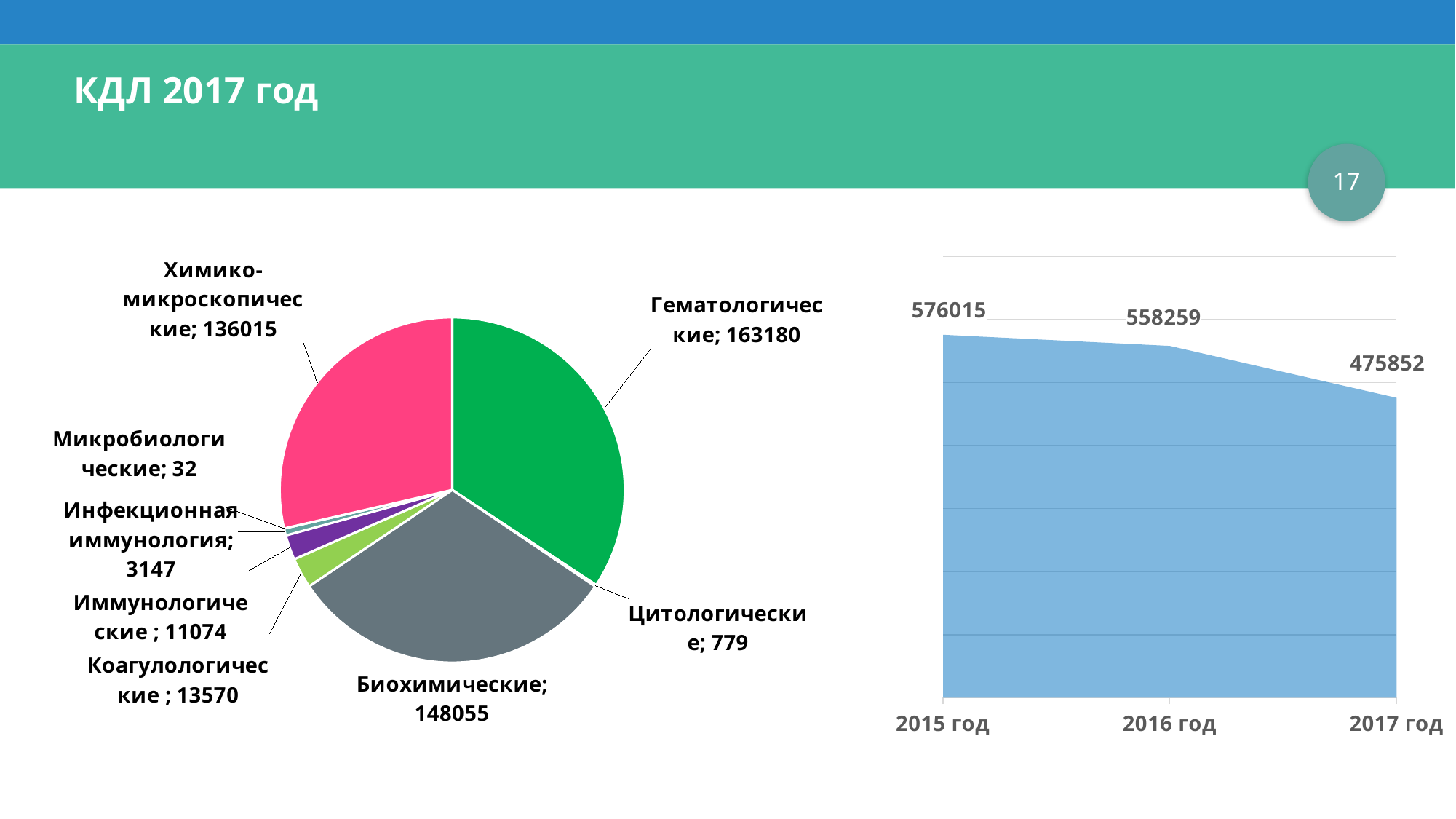
How many categories does the pie chart on the left show? 8 In the pie chart on the left, what is the value for Микробиологические? 32 What kind of chart is on the right side of the slide? Area chart In the pie chart on the left, which is larger: Коагулологические or Иммунологические? Коагулологические In the pie chart on the left, which category has the largest value? Гематологические In the pie chart on the left, what is the difference between Гематологические and Химико-микроскопические? 27165 In the pie chart on the left, what is the value for Биохимические? 148055 In the chart on the right, what is the value for 2016 год? 558259 In the chart on the right, what is the difference between the values for 2016 год and 2017 год? 82407 In the pie chart on the left, which category has the smallest value? Микробиологические In the pie chart on the left, what is the value for Гематологические? 163180 In the chart on the right, do the values rise or fall from 2015 год to 2017 год? Fall